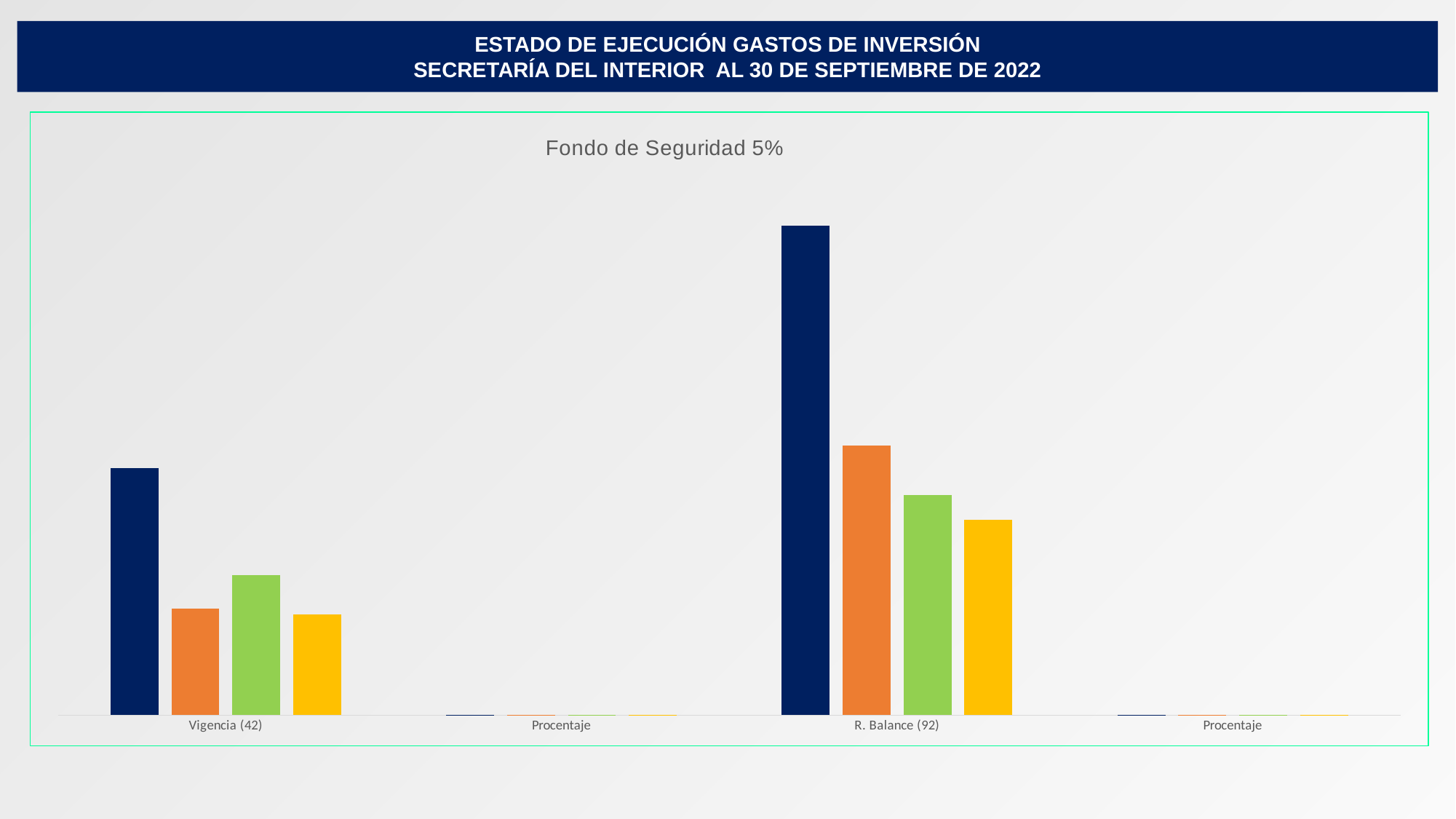
Is the dark blue bar taller for Vigencia (42) or for R. Balance (92)? R. Balance (92) Which colour bar is the tallest within the category Vigencia (42)? Dark blue What kind of chart is shown on the slide? Bar chart Within R. Balance (92), is the orange bar or the green bar taller? Orange How many bars are plotted for the category Vigencia (42)? 4 Within Vigencia (42), is the green bar or the orange bar taller? Green What is the title of the chart? Fondo de Seguridad 5% How many categories are shown along the x axis of the chart? 4 What is the label of the first category on the x axis? Vigencia (42) Which categories have bars that are barely visible above the baseline? The two Procentaje categories Which colour bar is the shortest within the category R. Balance (92)? Yellow Which category has the tallest bar in the chart? R. Balance (92)